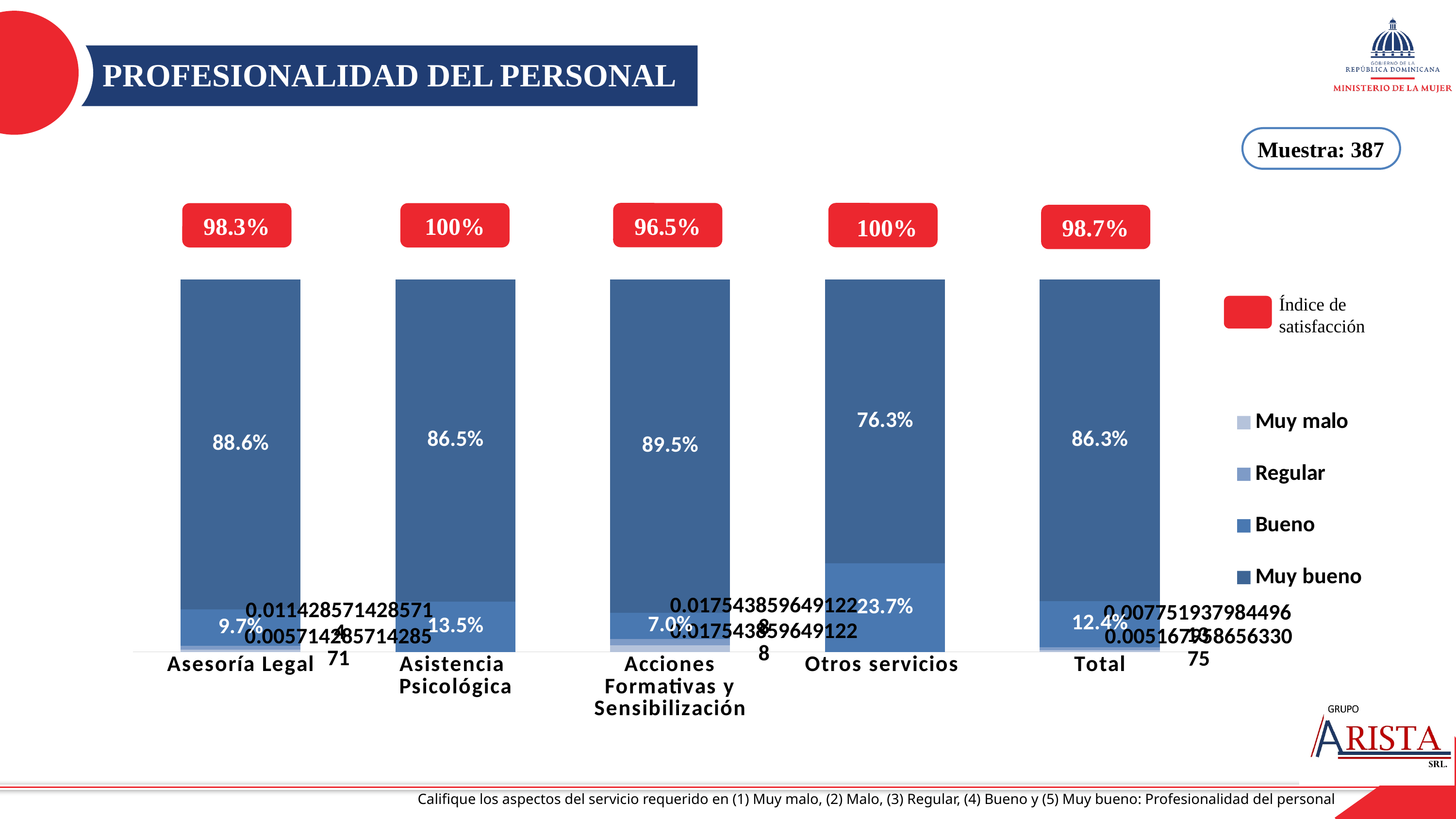
What is the Índice de satisfacción shown for Acciones Formativas y Sensibilización? 96.5% What is the sample size (Muestra) shown on the slide? 387 How many series does the legend list? 4 What is the Muy bueno value for Total? 86.3% Which is larger, the Muy bueno value for Asistencia Psicológica or for Total? Asistencia Psicológica What is the difference between the Bueno values for Otros servicios and Asesoría Legal? 14.0% Which category has the lowest Muy bueno value? Otros servicios What is the Muy bueno value for Asesoría Legal? 88.6% What is the Bueno value for Otros servicios? 23.7% Which category has the highest Muy bueno value? Acciones Formativas y Sensibilización What kind of chart is shown on the slide? Stacked bar chart How many categories are shown on the x axis? 5